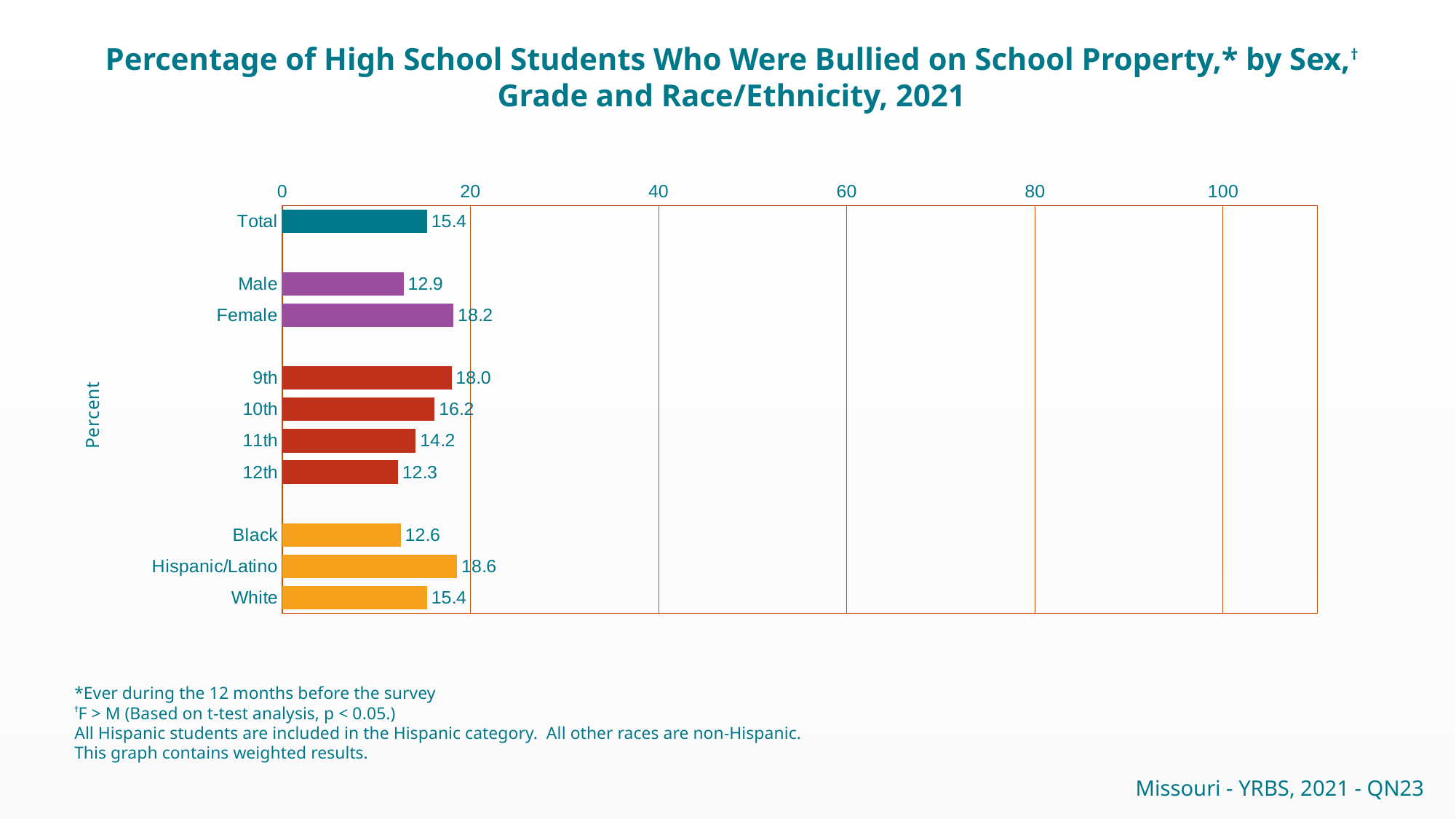
What is the difference between the Female and Male values? 5.3 What is the value for Female? 18.2 Which category has the highest value? Hispanic/Latino Which grade has the lowest value? 12th What is the value for Total? 15.4 What kind of chart is shown? bar chart What is the value for Hispanic/Latino? 18.6 What is the value for 12th grade? 12.3 How many categories are plotted in the chart? 10 Is the value for Black greater or less than 20? less What is the label on the vertical axis? Percent Which is larger, the value for 9th grade or 10th grade? 9th